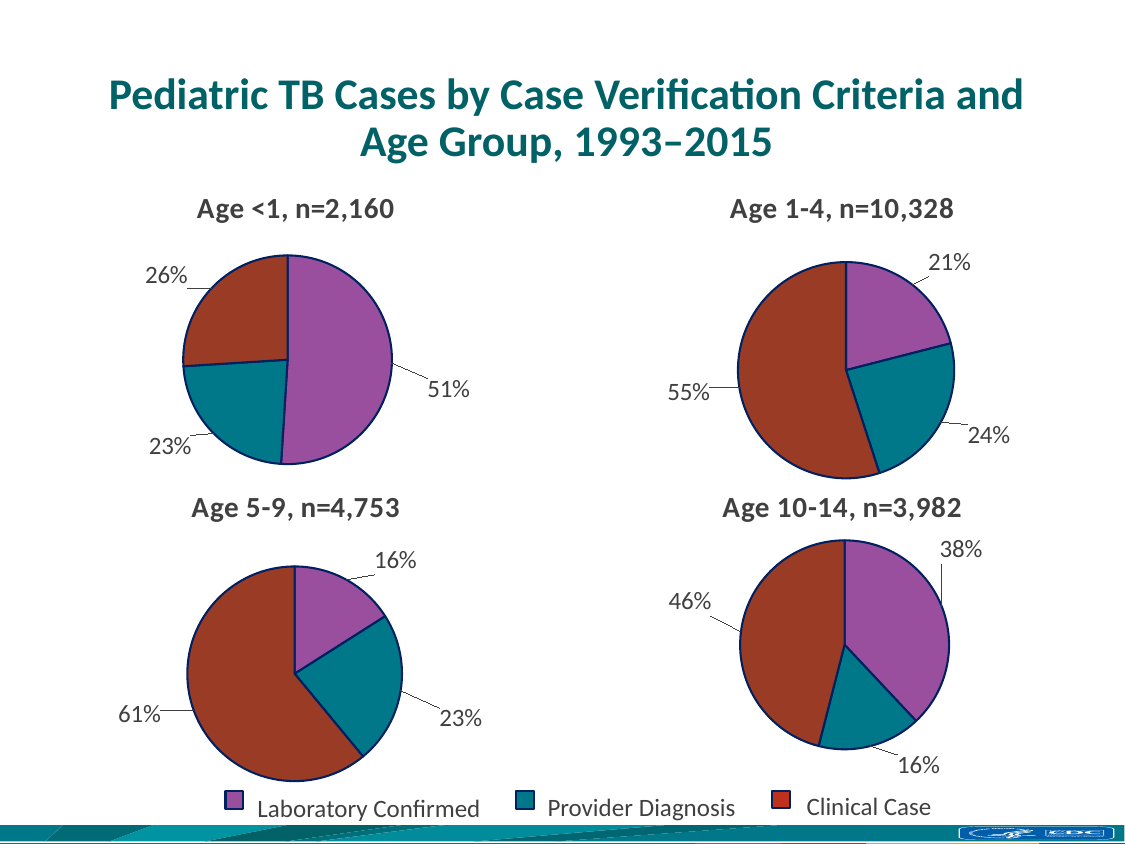
In the 'Age 10-14, n=3,982' pie chart, what share of cases is Laboratory Confirmed? 38% In the 'Age 1-4, n=10,328' pie chart, which is larger: the Laboratory Confirmed share or the Provider Diagnosis share? Provider Diagnosis How many categories does the legend list? 3 In the 'Age 5-9, n=4,753' pie chart, which category has the largest share? Clinical Case In the 'Age 5-9, n=4,753' pie chart, what share of cases is Provider Diagnosis? 23% In the 'Age 1-4, n=10,328' pie chart, what share of cases is Clinical Case? 55% Which colour represents Clinical Case in the legend? Red In the 'Age <1, n=2,160' pie chart, what is the difference between the Laboratory Confirmed share and the Clinical Case share? 25% In the 'Age 10-14, n=3,982' pie chart, which category has the smallest share? Provider Diagnosis What kind of chart is used for each age group on this slide? Pie chart How many pie charts are shown on the slide? 4